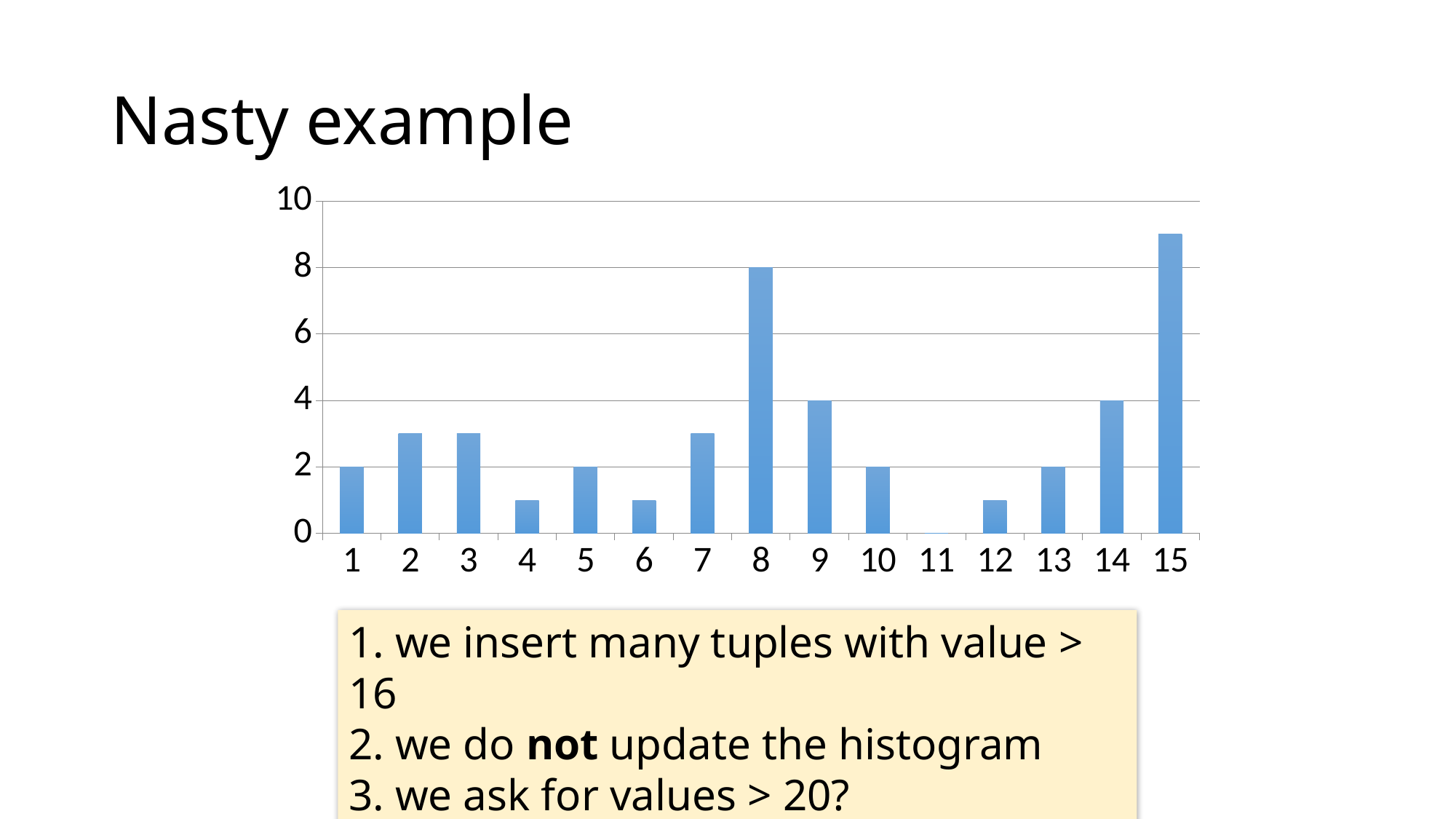
Is the value for category 4 greater or less than 2? less Which is larger, the value for category 8 or the value for category 9? category 8 Which category has the highest bar in the chart? 15 What is the value for category 8? 8 How many categories are shown on the x axis of the chart? 15 Is the value for category 15 greater or less than 8? greater What type of chart is shown on the slide? bar chart What is the value for category 9? 4 What is the value for category 1? 2 Which category has the lowest bar in the chart? 11 What is the value for category 14? 4 What is the difference between the values for category 8 and category 9? 4